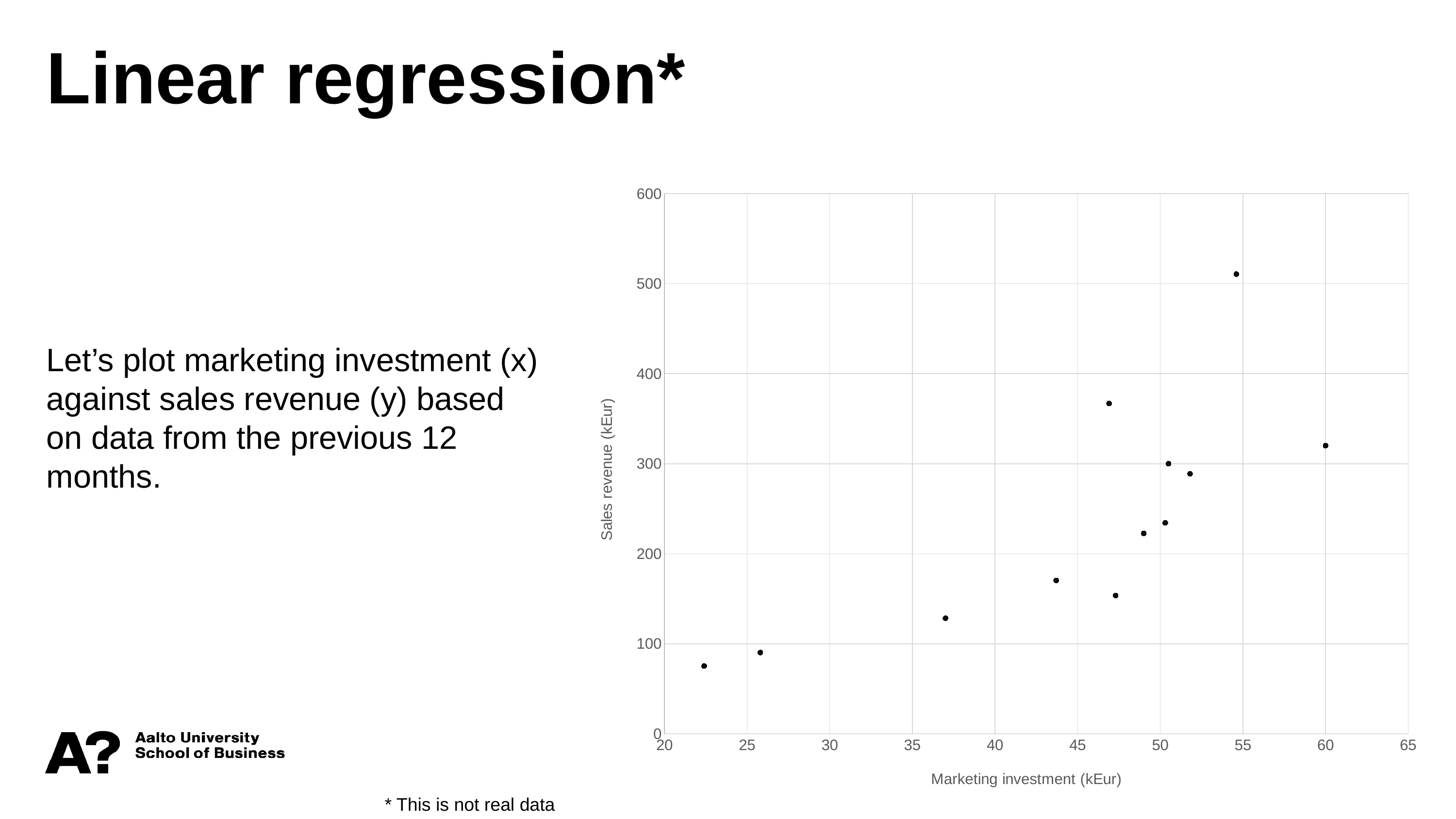
What is the label of the y axis of the chart? Sales revenue (kEur) Overall, does sales revenue tend to rise or fall as marketing investment increases along the x axis? Rise Is the sales revenue of the point with the highest marketing investment (around 60 kEur) greater or less than 300? greater Which has the lower sales revenue: the point at a marketing investment of about 22 kEur or the point at about 26 kEur? The point at about 22 kEur Is the sales revenue of the point with the lowest marketing investment greater or less than 100? less How many data points are plotted on the chart? 12 What is the label of the x axis of the chart? Marketing investment (kEur) Which has the higher sales revenue: the point at a marketing investment of about 60 kEur or the point at about 55 kEur? The point at about 55 kEur Is the highest sales revenue on the chart greater or less than 400? greater What kind of chart is shown on the slide? Scatter plot